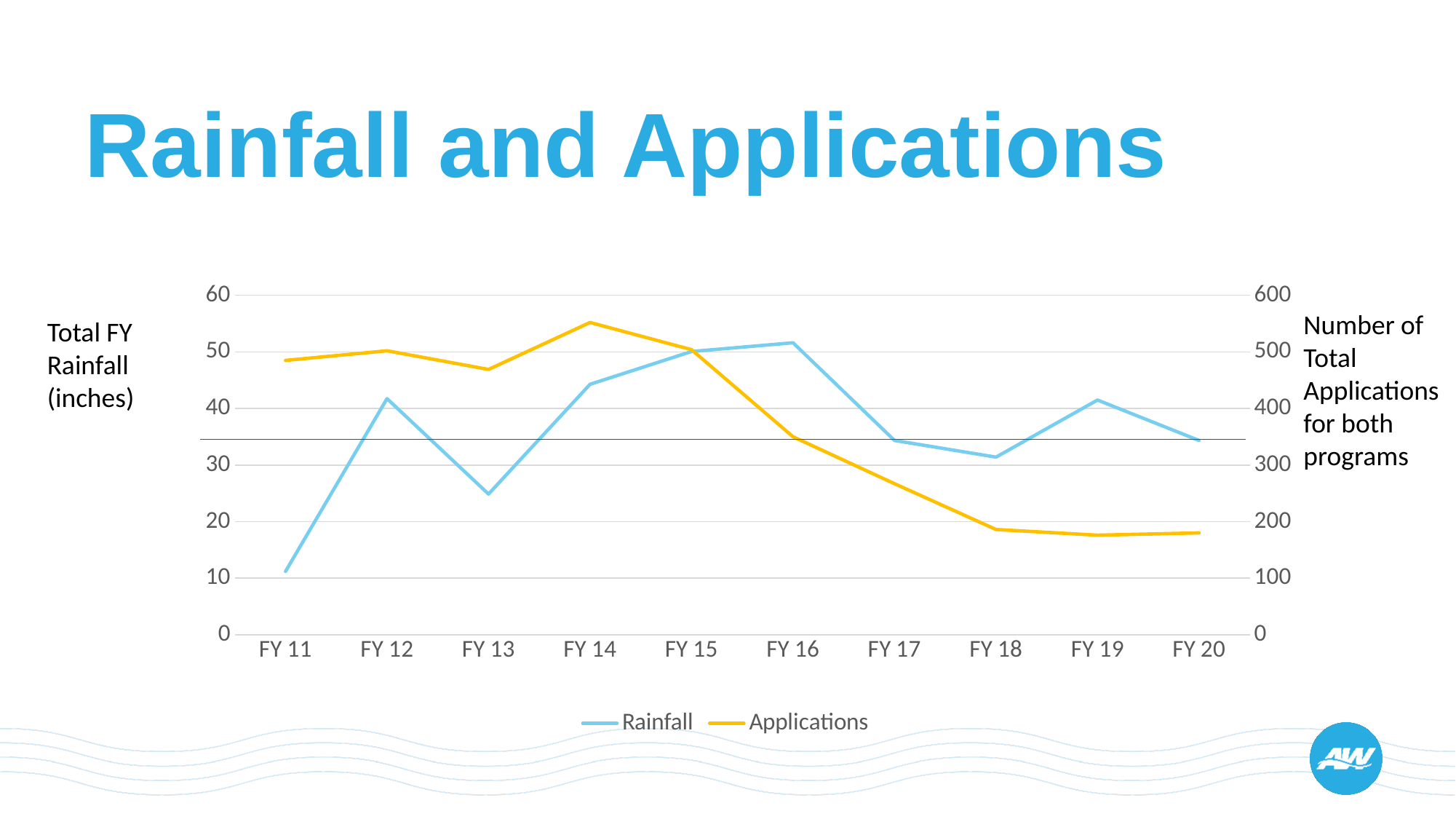
Is the Rainfall value for FY 11 greater or less than 20? less In which fiscal year is Rainfall at its lowest? FY 11 In which fiscal year are Applications at their highest? FY 14 What is the label on the left vertical axis? Total FY Rainfall (inches) Which fiscal year has the higher Rainfall, FY 12 or FY 13? FY 12 How many fiscal years are plotted along the x axis? 10 What kind of chart is shown on the slide? Line chart In which fiscal year is Rainfall at its highest? FY 16 Is the Applications value for FY 18 greater or less than 200? less How many series does the legend list? 2 Is the Applications value for FY 14 greater or less than 500? greater Do Applications rise or fall from FY 15 to FY 18? Fall